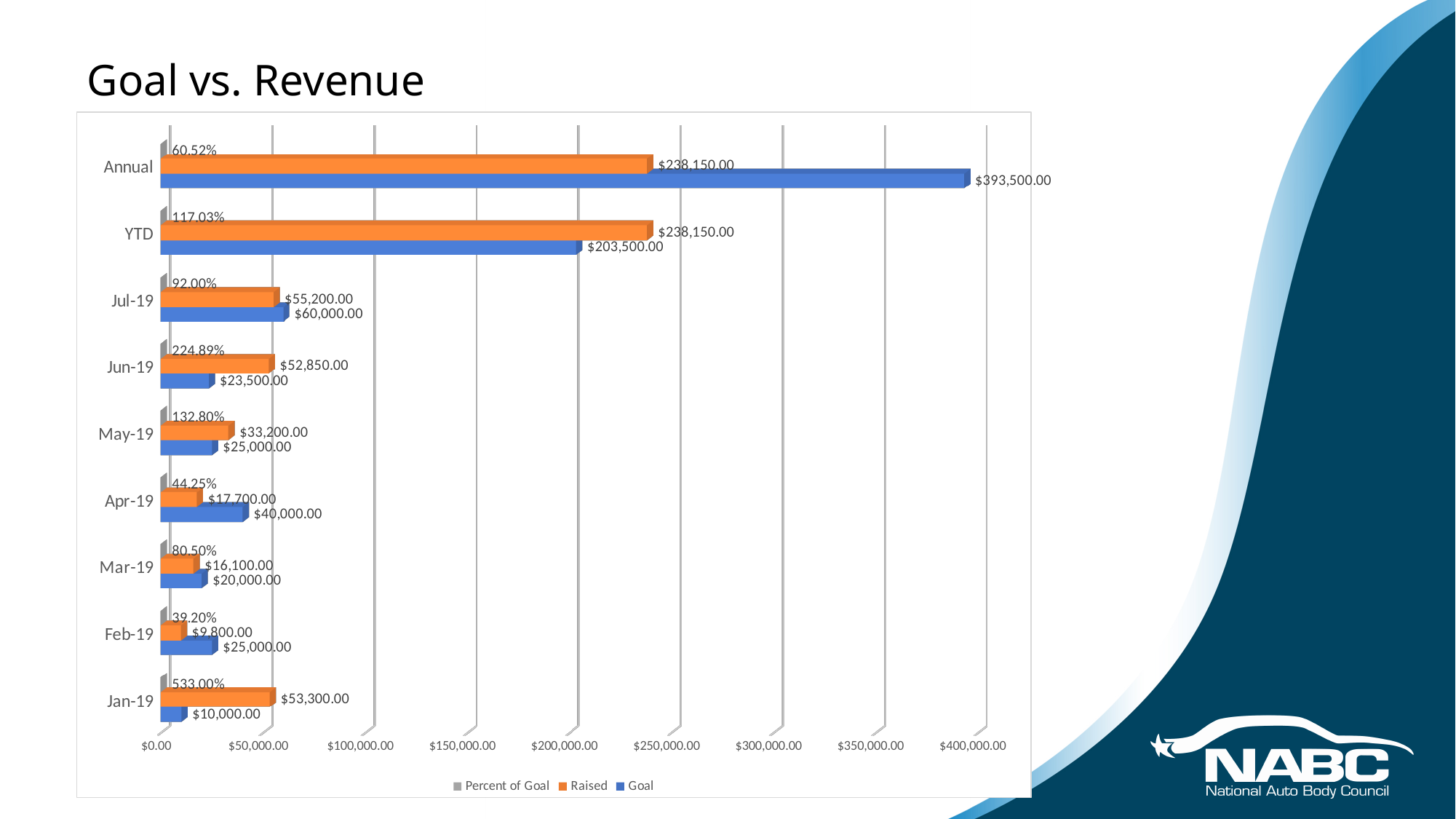
What is the Goal value for Annual? $393,500.00 Among the monthly categories (Jan-19 to Jul-19), which month has the highest Raised value? Jul-19 What is the Raised value for Jun-19? $52,850.00 What is the Percent of Goal for Jan-19? 533.00% Which category has the lowest Raised value? Feb-19 Is the Goal value for YTD greater or less than $200,000.00? greater What is the difference between the Goal and Raised values for Annual? $155,350.00 What kind of chart is shown on the slide? Bar chart What is the Goal value for Apr-19? $40,000.00 Which is larger for Mar-19, the Goal or the Raised value? Goal How many categories are shown on the vertical axis? 9 How many series does the legend list? 3